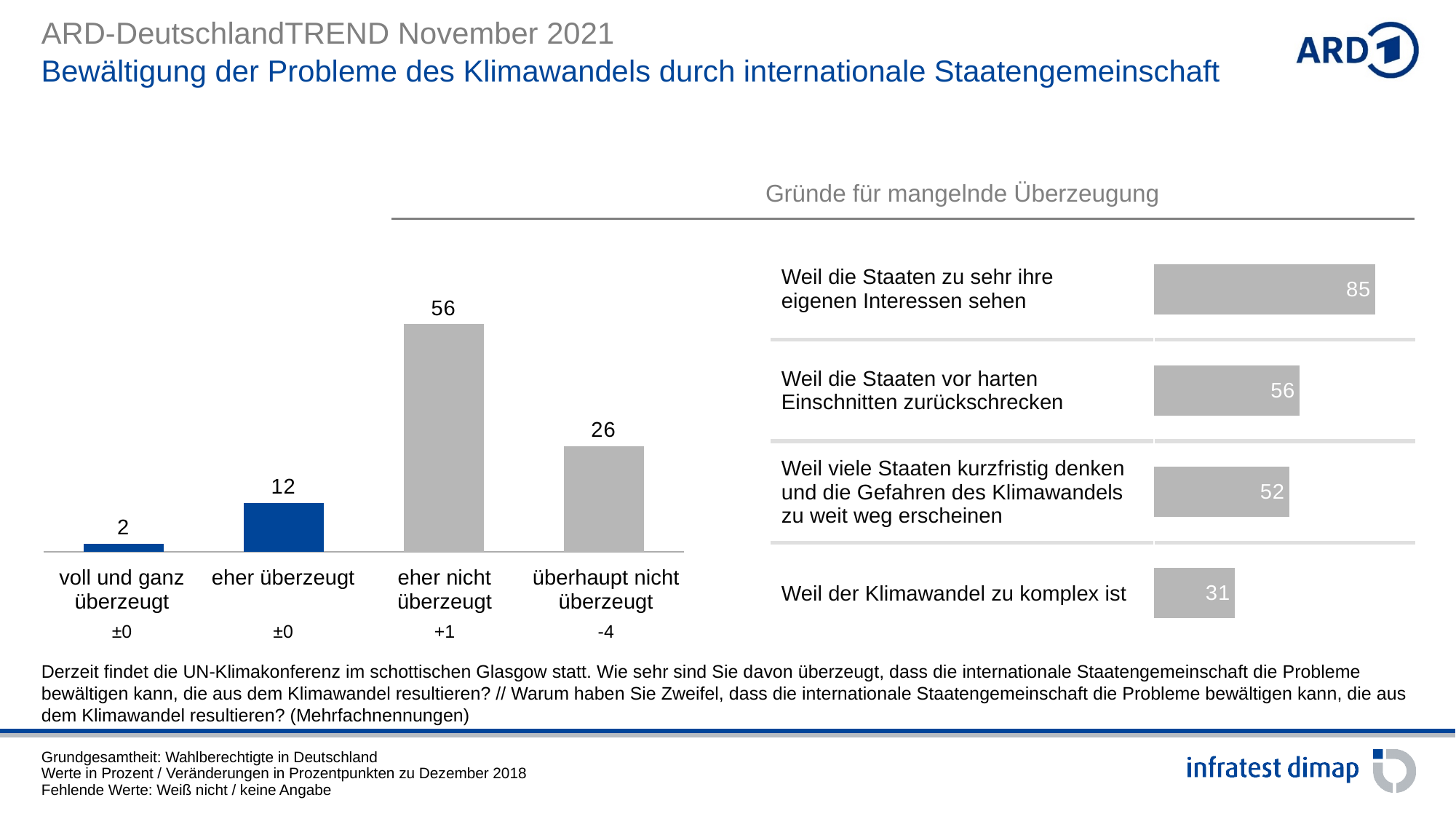
In the left bar chart, what is the difference between "eher nicht überzeugt" and "überhaupt nicht überzeugt"? 30 What type of chart is the chart titled "Gründe für mangelnde Überzeugung"? bar chart In the left bar chart, which category has the lowest value? voll und ganz überzeugt In the left bar chart, what change in percentage points is shown below "überhaupt nicht überzeugt"? -4 In the chart titled "Gründe für mangelnde Überzeugung", which is larger: "Weil die Staaten vor harten Einschnitten zurückschrecken" or "Weil viele Staaten kurzfristig denken und die Gefahren des Klimawandels zu weit weg erscheinen"? Weil die Staaten vor harten Einschnitten zurückschrecken In the left bar chart, what is the value for "eher überzeugt"? 12 In the left bar chart, which category has the highest value? eher nicht überzeugt In the chart titled "Gründe für mangelnde Überzeugung", what is the value for "Weil der Klimawandel zu komplex ist"? 31 How many categories does the left bar chart show? 4 In the chart titled "Gründe für mangelnde Überzeugung", which reason has the highest value? Weil die Staaten zu sehr ihre eigenen Interessen sehen In the left bar chart, what is the value for "überhaupt nicht überzeugt"? 26 In the chart titled "Gründe für mangelnde Überzeugung", what is the difference between "Weil die Staaten zu sehr ihre eigenen Interessen sehen" and "Weil die Staaten vor harten Einschnitten zurückschrecken"? 29